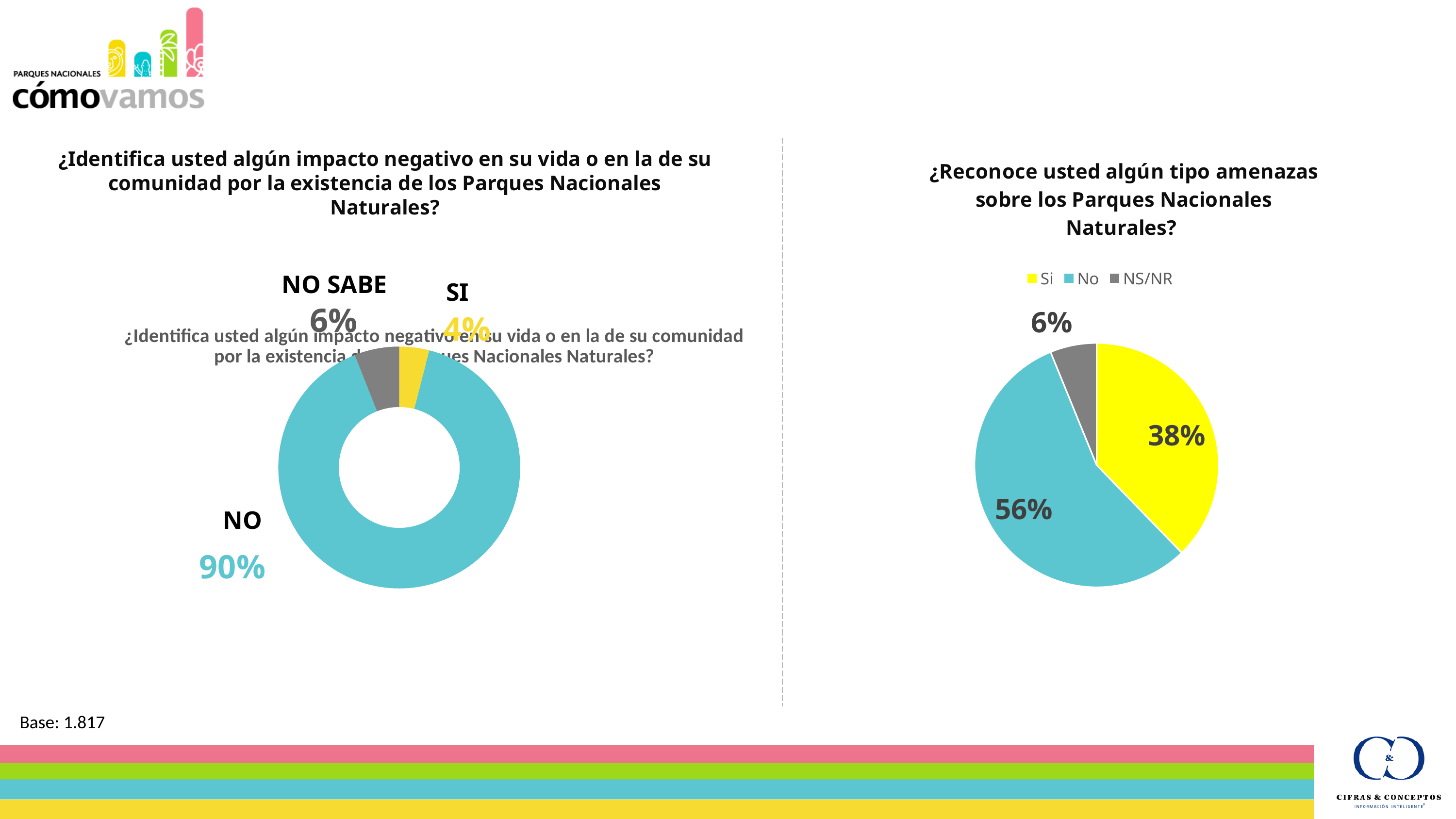
In the right chart (¿Reconoce usted algún tipo amenazas...?), what percentage answered Si? 38% How many entries does the legend of the right chart (¿Reconoce usted algún tipo amenazas...?) list? 3 In the left chart (¿Identifica usted algún impacto negativo...?), what percentage answered SI? 4% In the right chart (¿Reconoce usted algún tipo amenazas...?), which colour represents Si? Yellow In the left chart (¿Identifica usted algún impacto negativo...?), what percentage answered NO? 90% In the right chart (¿Reconoce usted algún tipo amenazas...?), what is the difference between No and Si? 18% What kind of chart is the left chart (¿Identifica usted algún impacto negativo...?)? Doughnut chart In the right chart (¿Reconoce usted algún tipo amenazas...?), what percentage answered No? 56% In the left chart (¿Identifica usted algún impacto negativo...?), which category has the largest share? NO In the left chart (¿Identifica usted algún impacto negativo...?), what percentage is NO SABE? 6% In the left chart (¿Identifica usted algún impacto negativo...?), which category has the smallest share? SI In the left chart (¿Identifica usted algún impacto negativo...?), what is the difference between NO and SI? 86%